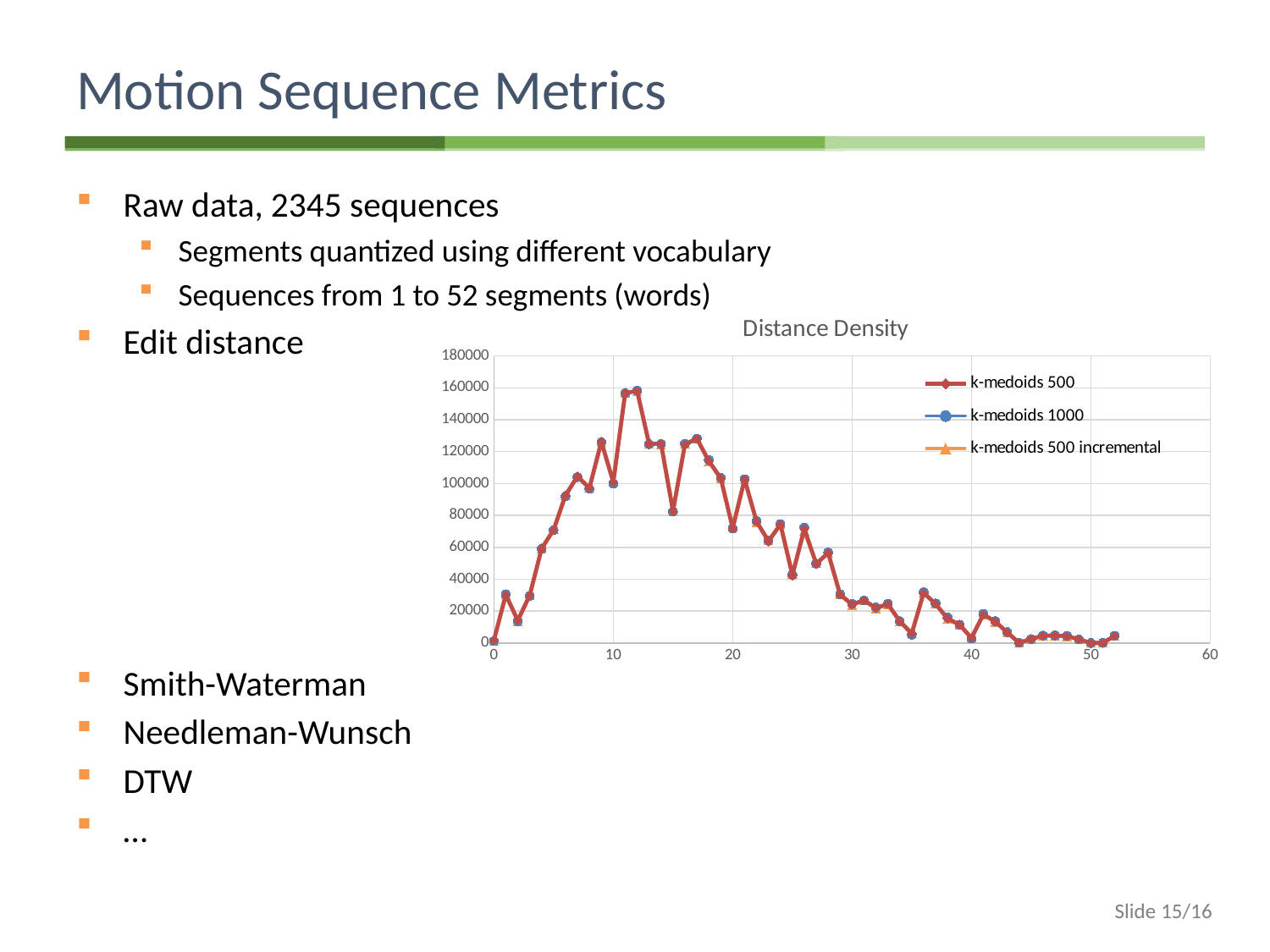
What is the title of the chart on the slide? Distance Density In the Distance Density chart, is the value at x = 15 greater or less than 100000? less What kind of chart is the Distance Density chart? line chart In the Distance Density chart, is the value at x = 9 greater or less than 120000? greater In the Distance Density chart, is the value at x = 50 greater or less than 20000? less Which series in the Distance Density chart is drawn in blue? k-medoids 1000 In the Distance Density chart, do the values generally rise or fall between x = 0 and x = 10? rise How many series does the legend of the Distance Density chart list? 3 In the Distance Density chart, do the values generally rise or fall between x = 30 and x = 50? fall